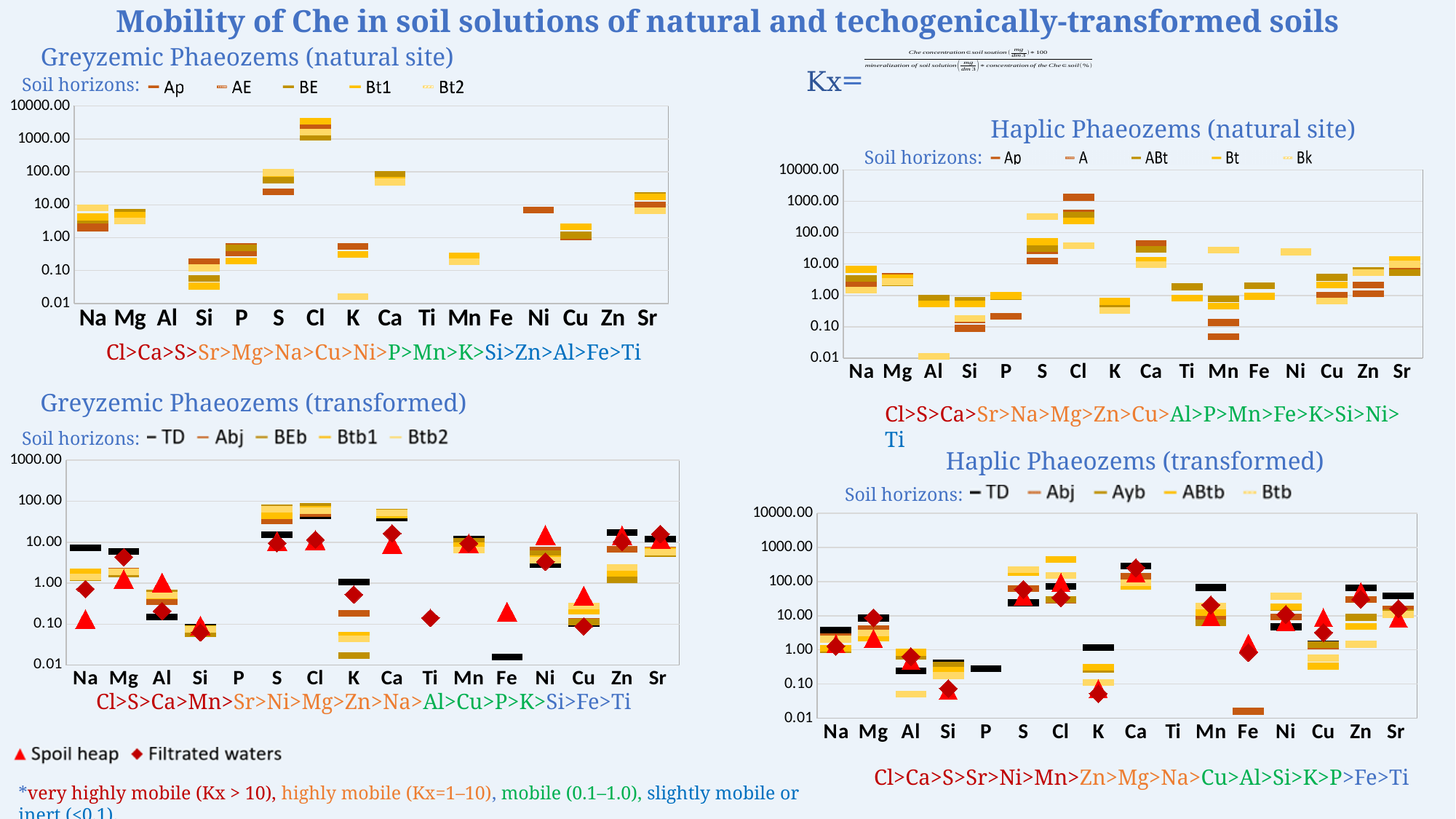
In the Greyzemic Phaeozems (natural site) chart, are the values for Si greater or less than 1.00? less What kind of chart is the Haplic Phaeozems (transformed) chart? line chart How many elements are labelled on the x axis of the Greyzemic Phaeozems (natural site) chart? 16 How many soil horizons does the legend list for the Greyzemic Phaeozems (transformed) chart? 5 In the Greyzemic Phaeozems (natural site) chart, which element has the highest Kx values? Cl In the Greyzemic Phaeozems (transformed) chart, are the soil horizon values for Cl greater or less than 10.00? greater In the Haplic Phaeozems (natural site) chart, which element reaches the highest Kx value? Cl Which soil horizons are listed in the legend of the Haplic Phaeozems (natural site) chart? Ap, A, ABt, Bt, Bk In the Greyzemic Phaeozems (natural site) chart, are the values for Cl greater or less than 100? greater How many soil horizons does the legend list for the Greyzemic Phaeozems (natural site) chart? 5